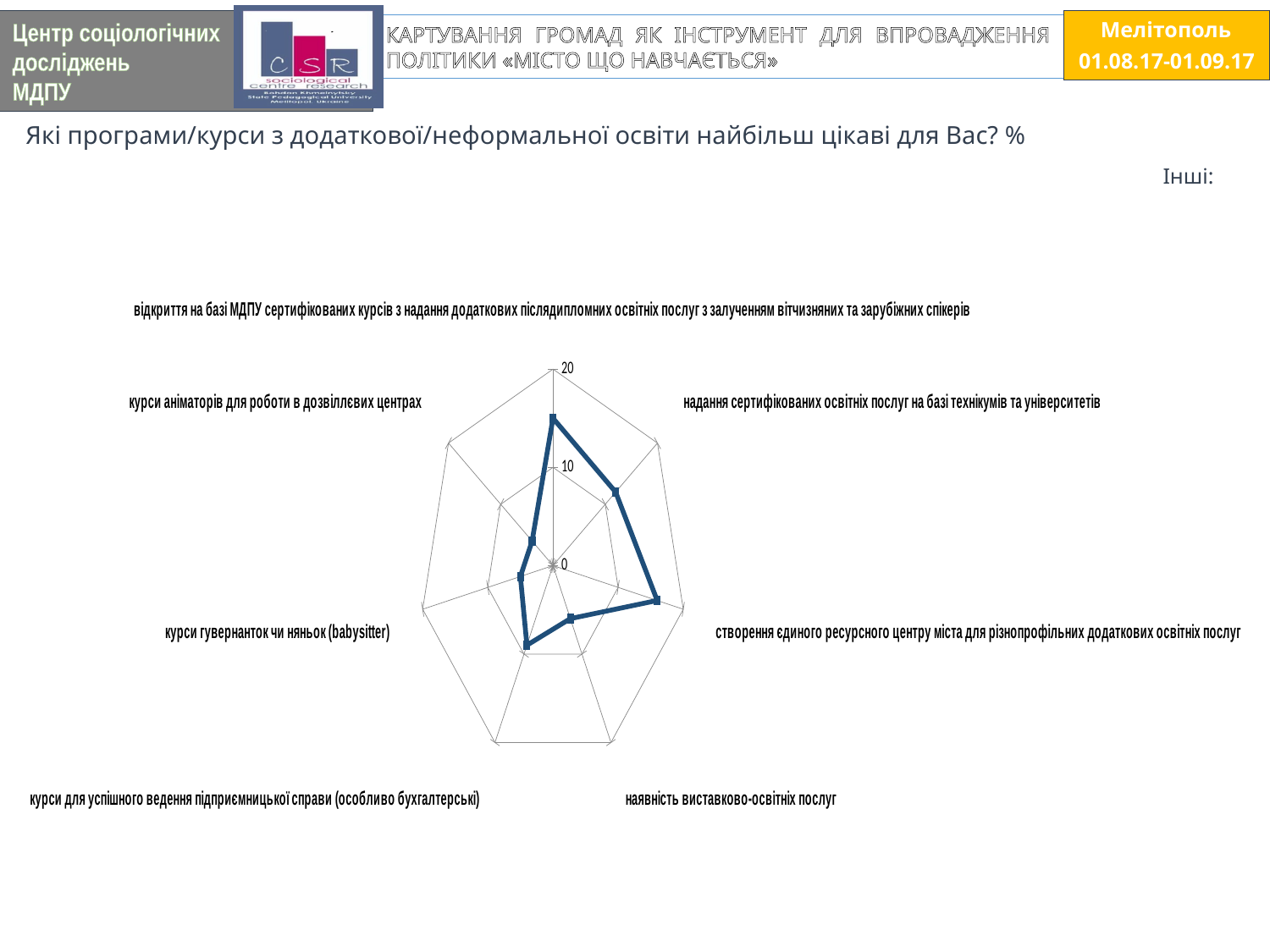
Is the value for "відкриття на базі МДПУ сертифікованих курсів з надання додаткових післядипломних освітніх послуг з залученням вітчизняних та зарубіжних спікерів" greater or less than 10? greater Is the value for "курси для успішного ведення підприємницької справи (особливо бухгалтерські)" greater or less than 10? less What is the maximum value shown on the radar chart's axis scale? 20 Which has the larger value: "відкриття на базі МДПУ сертифікованих курсів з надання додаткових післядипломних освітніх послуг з залученням вітчизняних та зарубіжних спікерів" or "наявність виставково-освітніх послуг"? відкриття на базі МДПУ сертифікованих курсів з надання додаткових післядипломних освітніх послуг з залученням вітчизняних та зарубіжних спікерів Which has the larger value: "створення єдиного ресурсного центру міста для різнопрофільних додаткових освітніх послуг" or "курси аніматорів для роботи в дозвіллєвих центрах"? створення єдиного ресурсного центру міста для різнопрофільних додаткових освітніх послуг Is the value for "відкриття на базі МДПУ сертифікованих курсів з надання додаткових післядипломних освітніх послуг з залученням вітчизняних та зарубіжних спікерів" greater or less than 20? less What kind of chart is shown on the slide? radar chart How many categories (axes) does the radar chart have? 7